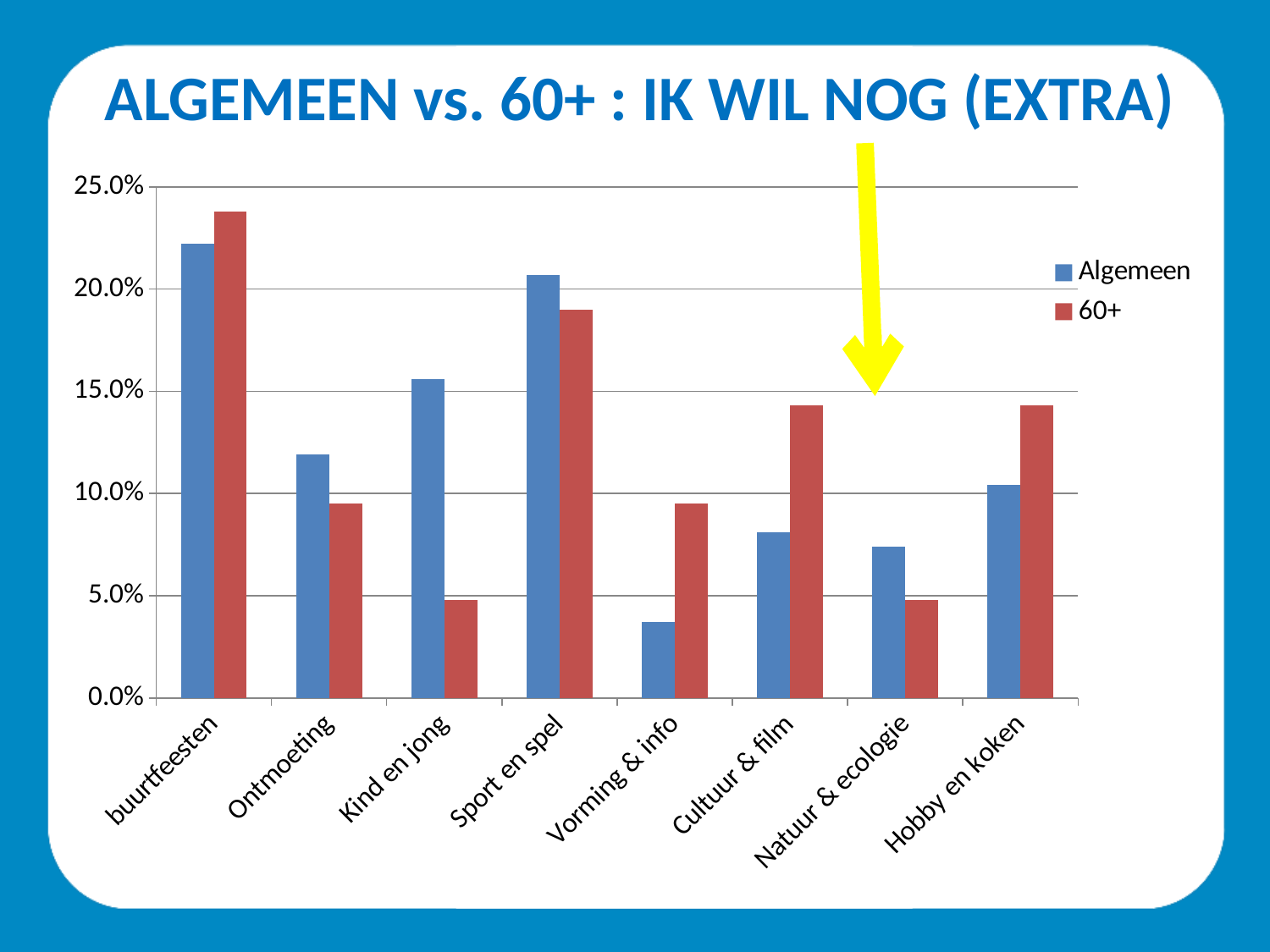
Which category has the highest value for the Algemeen series? buurtfeesten Which category has the highest value for the 60+ series? buurtfeesten Which series is shown in red in the legend? 60+ Which category has the lowest value for the Algemeen series? Vorming & info How many series does the legend list? 2 Is the Algemeen value for Vorming & info greater or less than 5.0%? less For Cultuur & film, which series has the larger value, Algemeen or 60+? 60+ Is the Algemeen value for Sport en spel greater or less than 20.0%? greater Is the 60+ value for Cultuur & film greater or less than 10.0%? greater What type of chart is shown on the slide? bar chart How many categories are shown on the x axis? 8 For Kind en jong, which series has the larger value, Algemeen or 60+? Algemeen